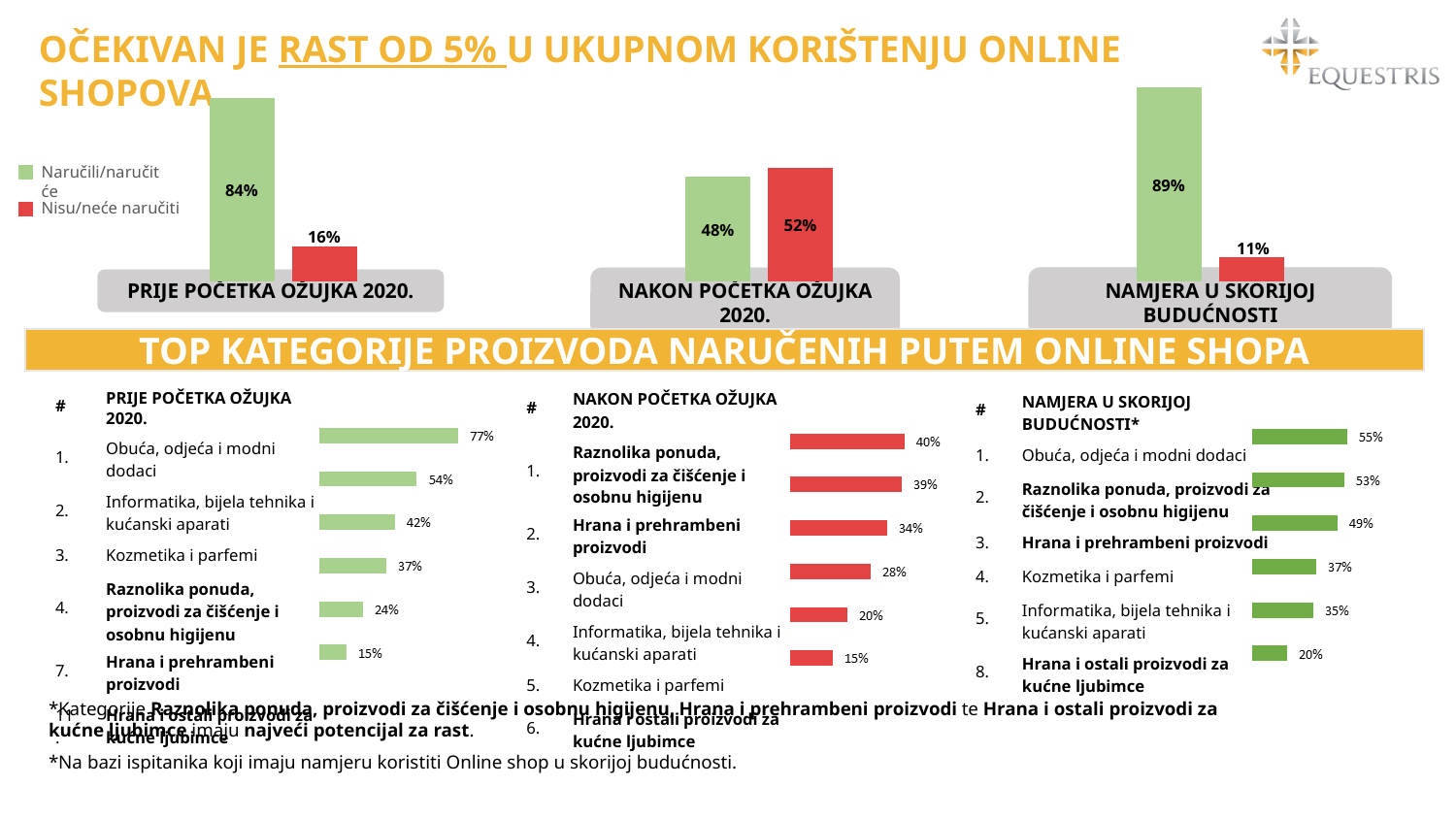
In the bottom-left 'Prije početka ožujka 2020.' category chart, what is the value for 'Obuća, odjeća i modni dodaci'? 77% In the bottom-left 'Prije početka ožujka 2020.' category chart, which category has the lowest value? Hrana i ostali proizvodi za kućne ljubimce How many categories are plotted in the bottom-right 'Namjera u skorijoj budućnosti*' category chart? 6 In the bottom-right 'Namjera u skorijoj budućnosti*' category chart, what is the difference between 'Obuća, odjeća i modni dodaci' and 'Hrana i ostali proizvodi za kućne ljubimce'? 35% In the bottom-middle 'Nakon početka ožujka 2020.' category chart, what is the value for 'Kozmetika i parfemi'? 20% In the 'Prije početka ožujka 2020.' chart at the top of the slide, what is the value for 'Naručili/naručit će'? 84% What kind of chart is used for the 'Prije početka ožujka 2020.' chart at the top of the slide? bar chart In the 'Nakon početka ožujka 2020.' chart at the top of the slide, what is the value for 'Nisu/neće naručiti'? 52% In the 'Nakon početka ožujka 2020.' chart at the top of the slide, which is larger: 'Naručili/naručit će' or 'Nisu/neće naručiti'? Nisu/neće naručiti How many series does the legend list for the top charts on the slide? 2 In the bottom-middle 'Nakon početka ožujka 2020.' category chart, which category has the highest value? Raznolika ponuda, proizvodi za čišćenje i osobnu higijenu In the 'Namjera u skorijoj budućnosti' chart at the top of the slide, what is the difference between the 'Naručili/naručit će' and 'Nisu/neće naručiti' values? 78%